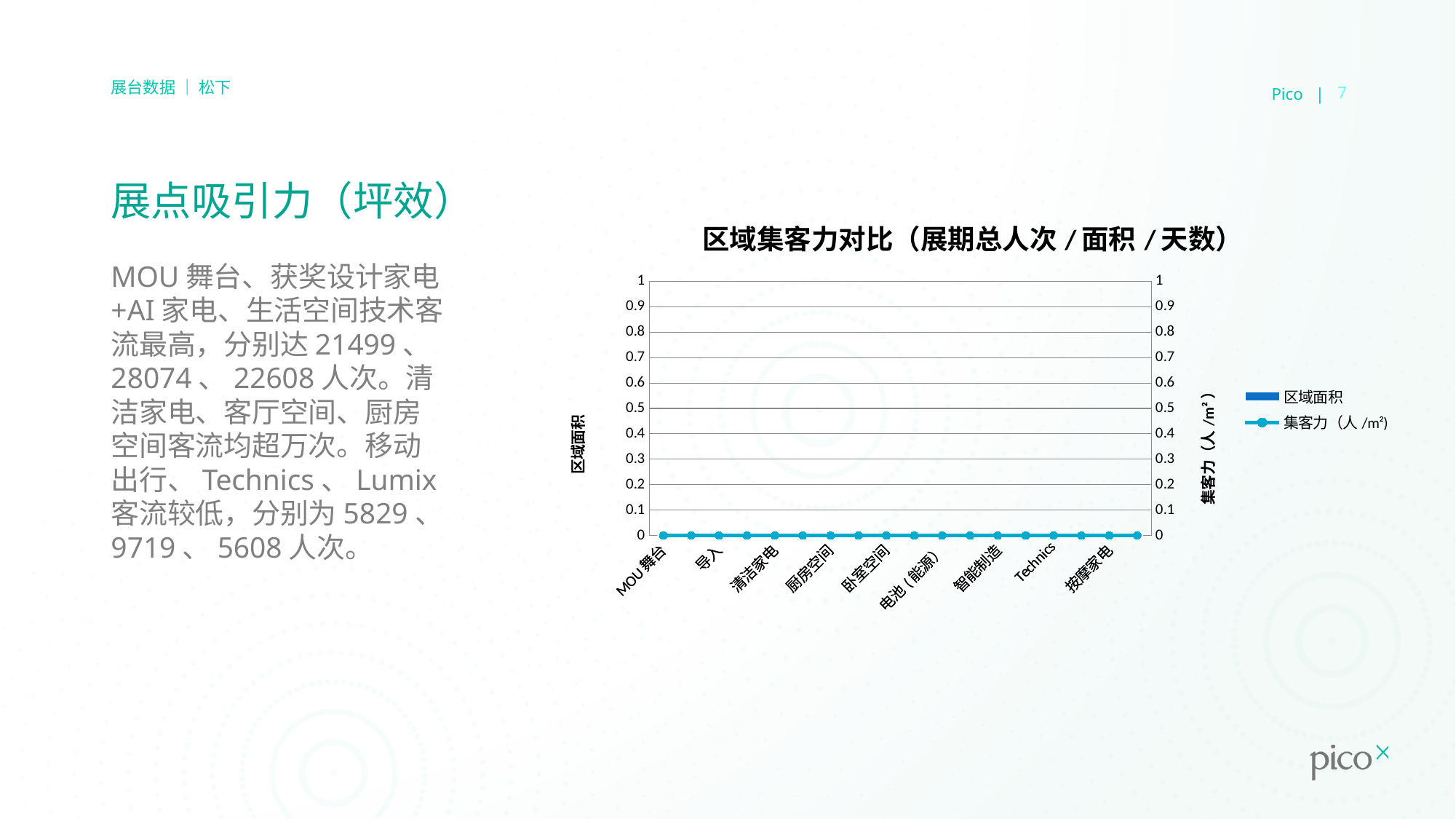
Is the value for 智能制造 greater or less than 0.1? less What is the plotted value of 集客力（人 /m²） for MOU 舞台? 0 Is the value for 厨房空间 greater or less than 0.5? less What is the difference between the plotted values for MOU 舞台 and 按摩家电? 0 What are the two series named in the chart's legend? 区域面积 and 集客力（人 /m²） How many series does the chart's legend list? 2 What is the highest tick value shown on the left vertical axis? 1 What is the title of the chart? 区域集客力对比（展期总人次 / 面积 / 天数） What is the plotted value of 集客力（人 /m²） for 清洁家电? 0 Do the plotted values rise, fall, or stay flat across the x axis? stay flat What is the plotted value of 集客力（人 /m²） for Technics? 0